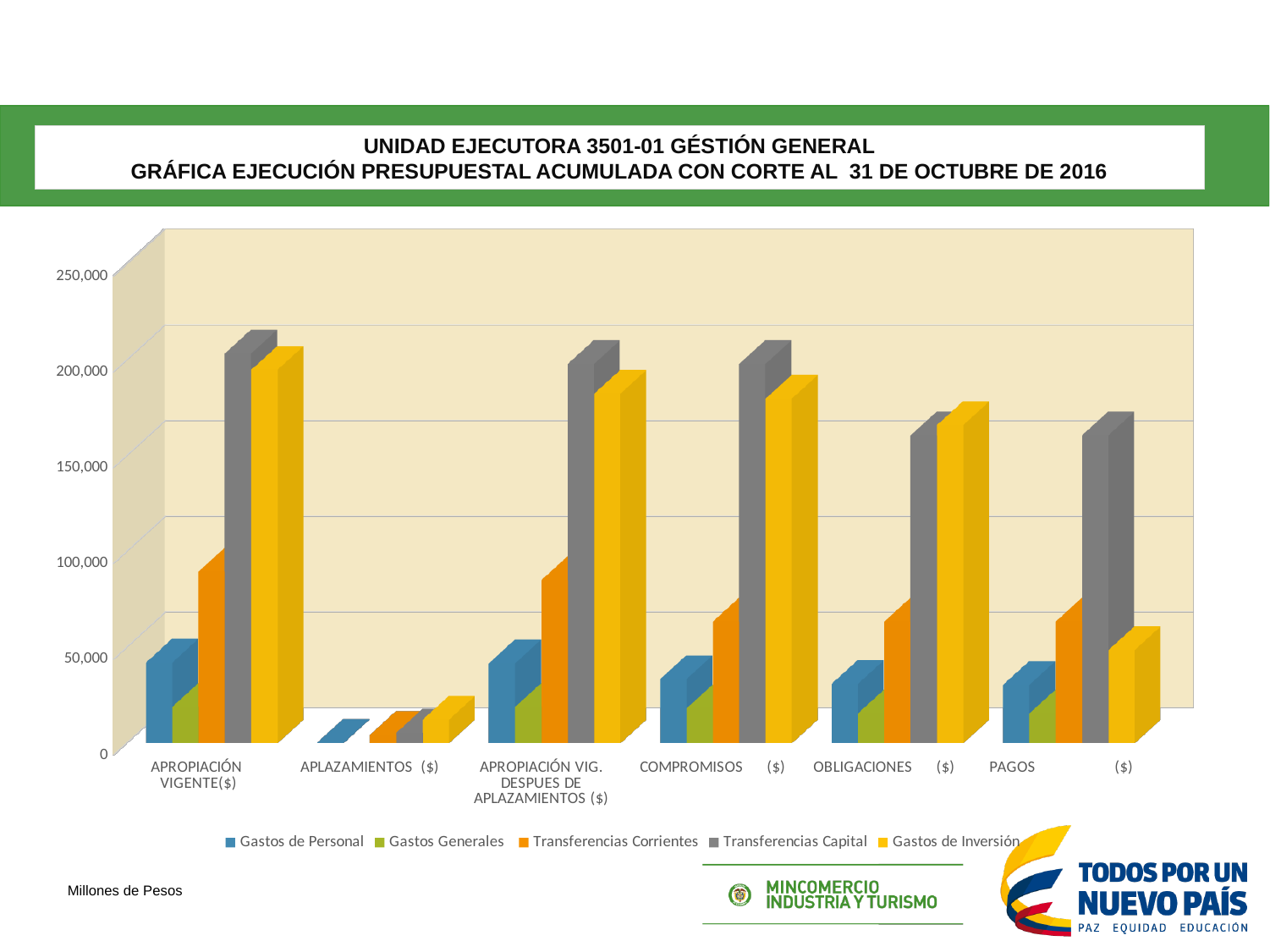
For APROPIACIÓN VIGENTE, which is larger: Gastos de Personal or Gastos Generales? Gastos de Personal What is the unit noted below the chart? Millones de Pesos For PAGOS, which is larger: Transferencias Capital or Gastos de Inversión? Transferencias Capital What kind of chart is shown on the slide? bar chart Do the Transferencias Capital values rise or fall from COMPROMISOS to OBLIGACIONES to PAGOS? They fall from COMPROMISOS to OBLIGACIONES, then stay the same from OBLIGACIONES to PAGOS Is the value of Transferencias Capital for APROPIACIÓN VIGENTE greater or less than 150,000? greater How many categories are shown along the x axis of the chart? 6 Which category has the lowest value for Transferencias Capital? APLAZAMIENTOS ($) Is the value of Gastos Generales for APROPIACIÓN VIGENTE greater or less than 50,000? less How many series does the chart legend list? 5 Is the value of Gastos de Inversión for PAGOS greater or less than 100,000? less Which series is shown in orange in the legend? Transferencias Corrientes